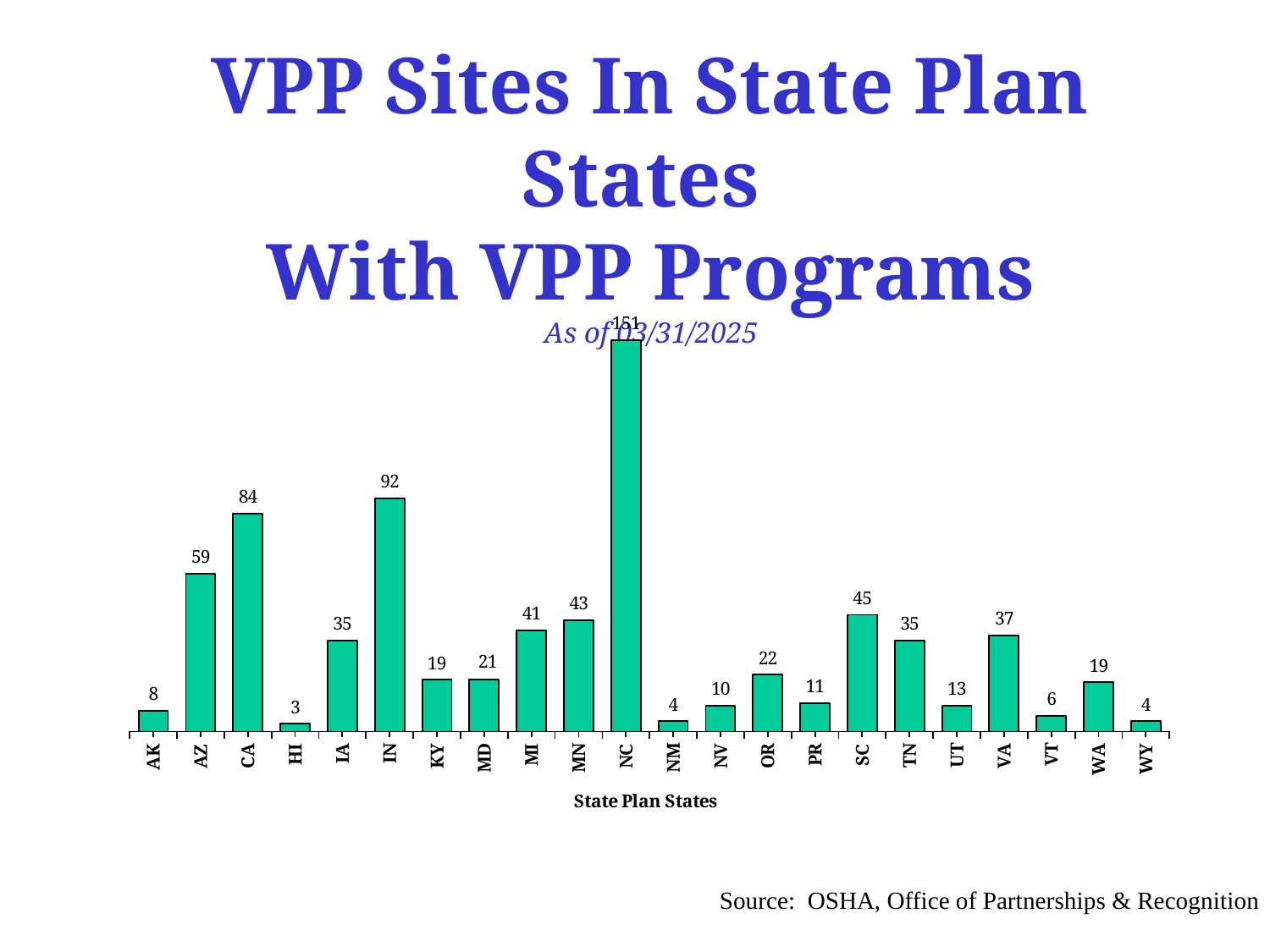
What is the difference between the values for SC and TN? 10 What is the value for IN? 92 Which state has the highest number of VPP sites? NC What is the value for VT? 6 What is the value for CA? 84 What is the title of the x axis? State Plan States Which state has the lowest number of VPP sites? HI How many states are shown on the x axis? 22 What kind of chart is shown on the slide? bar chart What is the difference between the values for CA and AZ? 25 Which is larger, the value for MN or the value for MI? MN What is the value for SC? 45